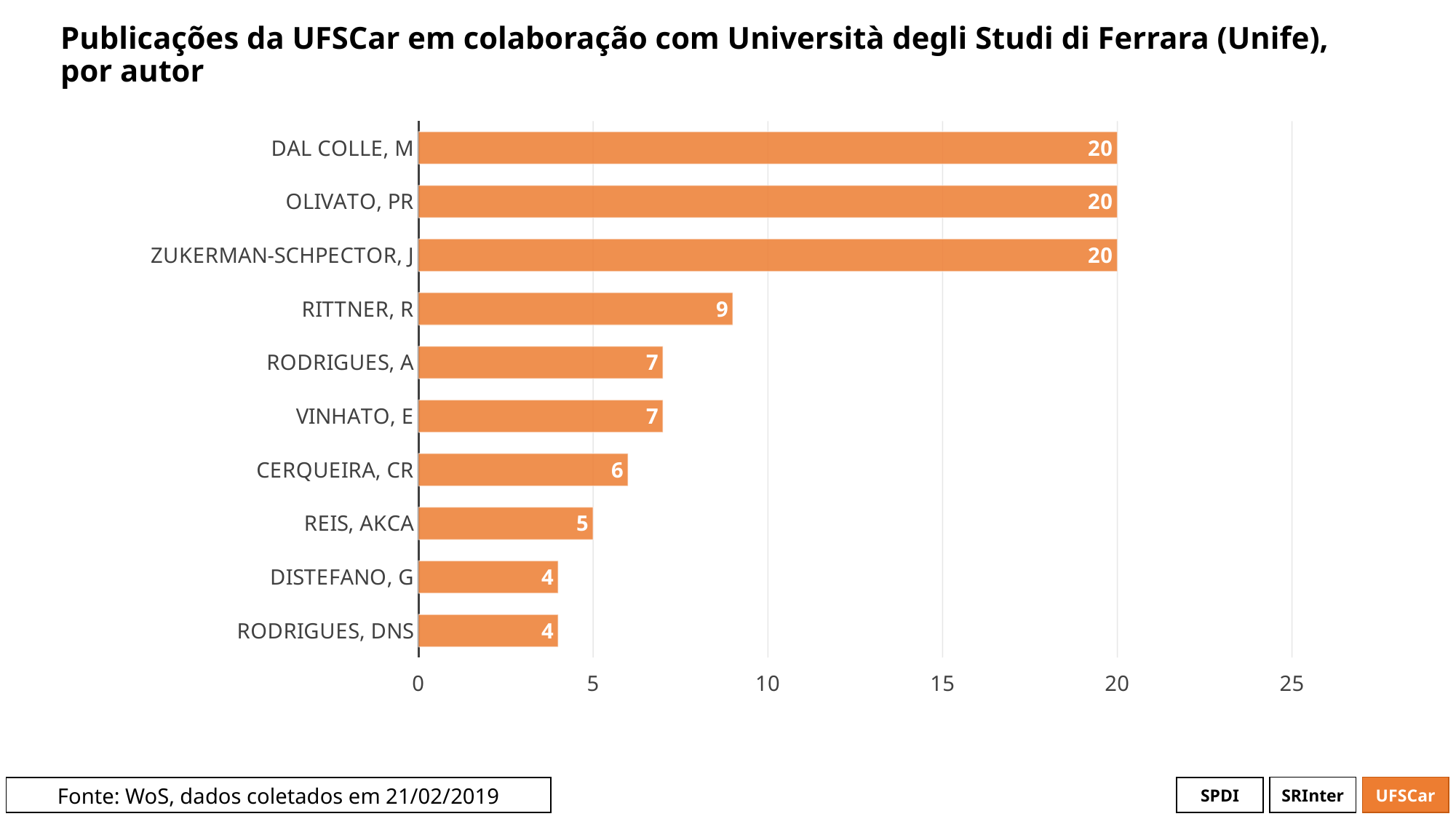
What is the difference between the values for RODRIGUES, A and REIS, AKCA? 2 What is the value for REIS, AKCA? 5 Which is larger, the value for VINHATO, E or the value for CERQUEIRA, CR? VINHATO, E Is the value for RITTNER, R greater or less than 10? less What kind of chart is shown on the slide? bar chart How many authors are shown in the chart? 10 What is the value for DISTEFANO, G? 4 What is the value for CERQUEIRA, CR? 6 Which author has the lowest value, RITTNER, R or RODRIGUES, DNS? RODRIGUES, DNS What is the difference between the values for DAL COLLE, M and RITTNER, R? 11 How many publications are shown for RITTNER, R? 9 What is the data source stated at the bottom of the slide? WoS, dados coletados em 21/02/2019